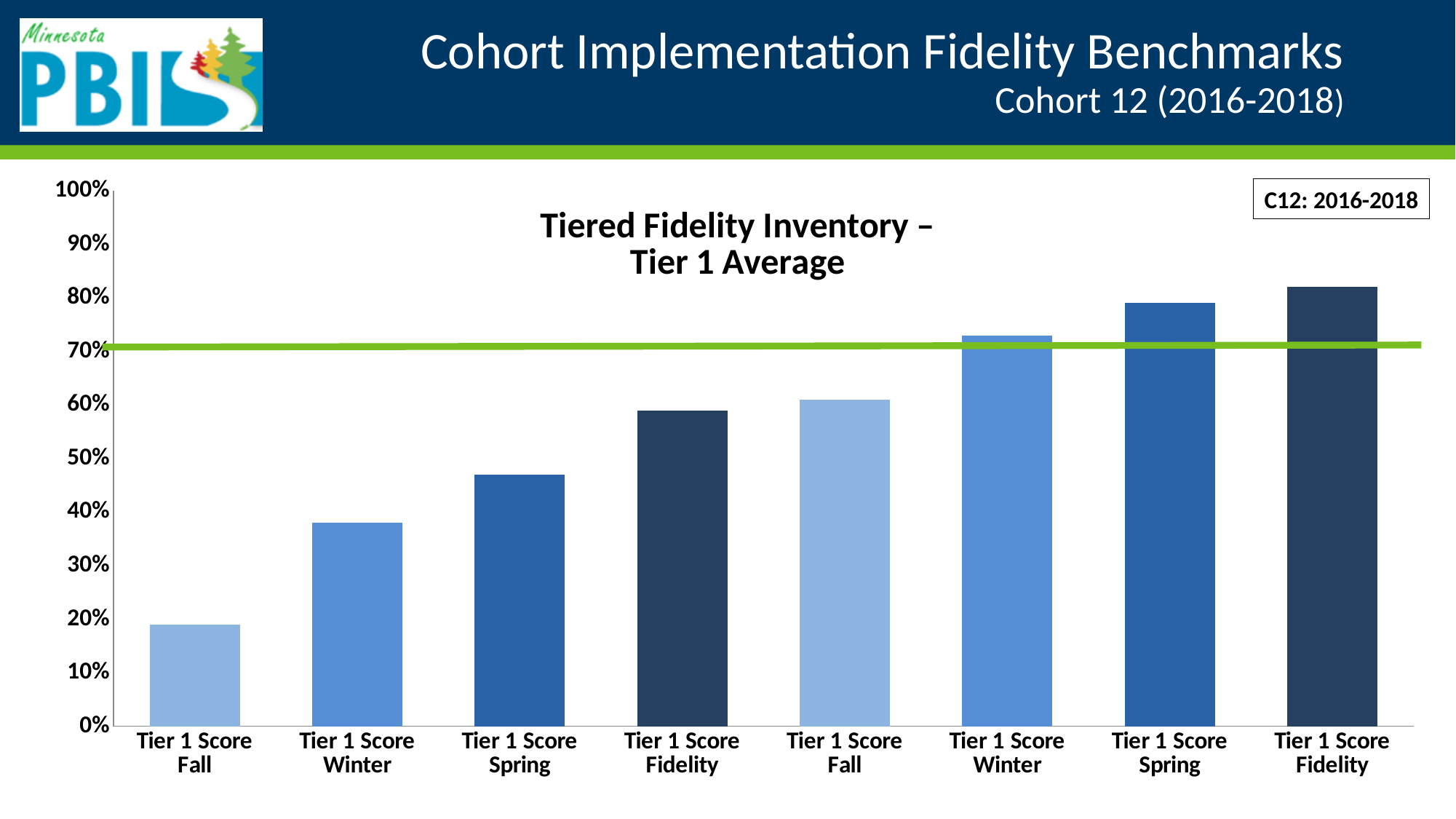
Which bar is the tallest in the chart? the second Tier 1 Score Fidelity bar (rightmost) Is the value for the first Tier 1 Score Winter bar greater or less than 30%? greater Is the value for the second Tier 1 Score Fall bar greater or less than 70%? less How many bars are plotted in the chart? 8 Is the value for the second Tier 1 Score Spring bar greater or less than 70%? greater What is the title of the chart? Tiered Fidelity Inventory – Tier 1 Average What kind of chart is shown on the slide? bar chart Which bar is the shortest in the chart? the first Tier 1 Score Fall bar (leftmost) Which is larger, the first Tier 1 Score Fidelity bar or the second Tier 1 Score Fidelity bar? the second Tier 1 Score Fidelity bar Do the bar values rise or fall from left to right across the chart? rise